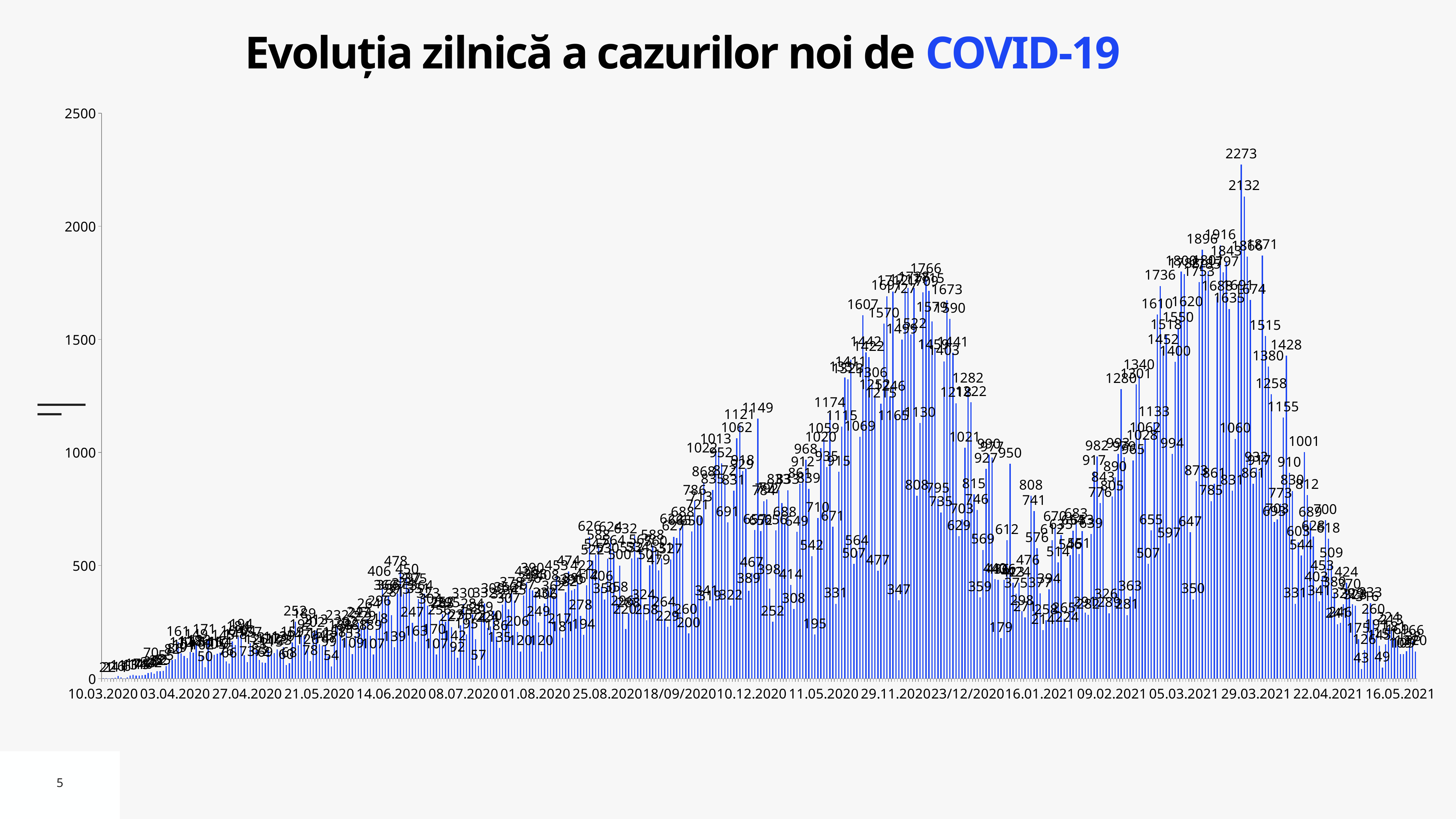
What is the highest tick value on the y axis? 2500 What is the title of the chart? Evoluția zilnică a cazurilor noi de COVID-19 What is the second highest daily value labelled on the chart? 2132 What is the first date shown on the x axis? 10.03.2020 Do the values rise or fall between 10.03.2020 and 03.04.2020? rise Is the tallest bar on the chart located in 2020 or in 2021? 2021 What is the difference between the two highest labelled values, 2273 and 2132? 141 What is the last date shown on the x axis? 16.05.2021 Is the highest value on the chart greater or less than 2500? less What is the highest daily value labelled on the chart? 2273 What kind of chart is shown on the slide? bar chart Is the highest value on the chart greater or less than 2000? greater